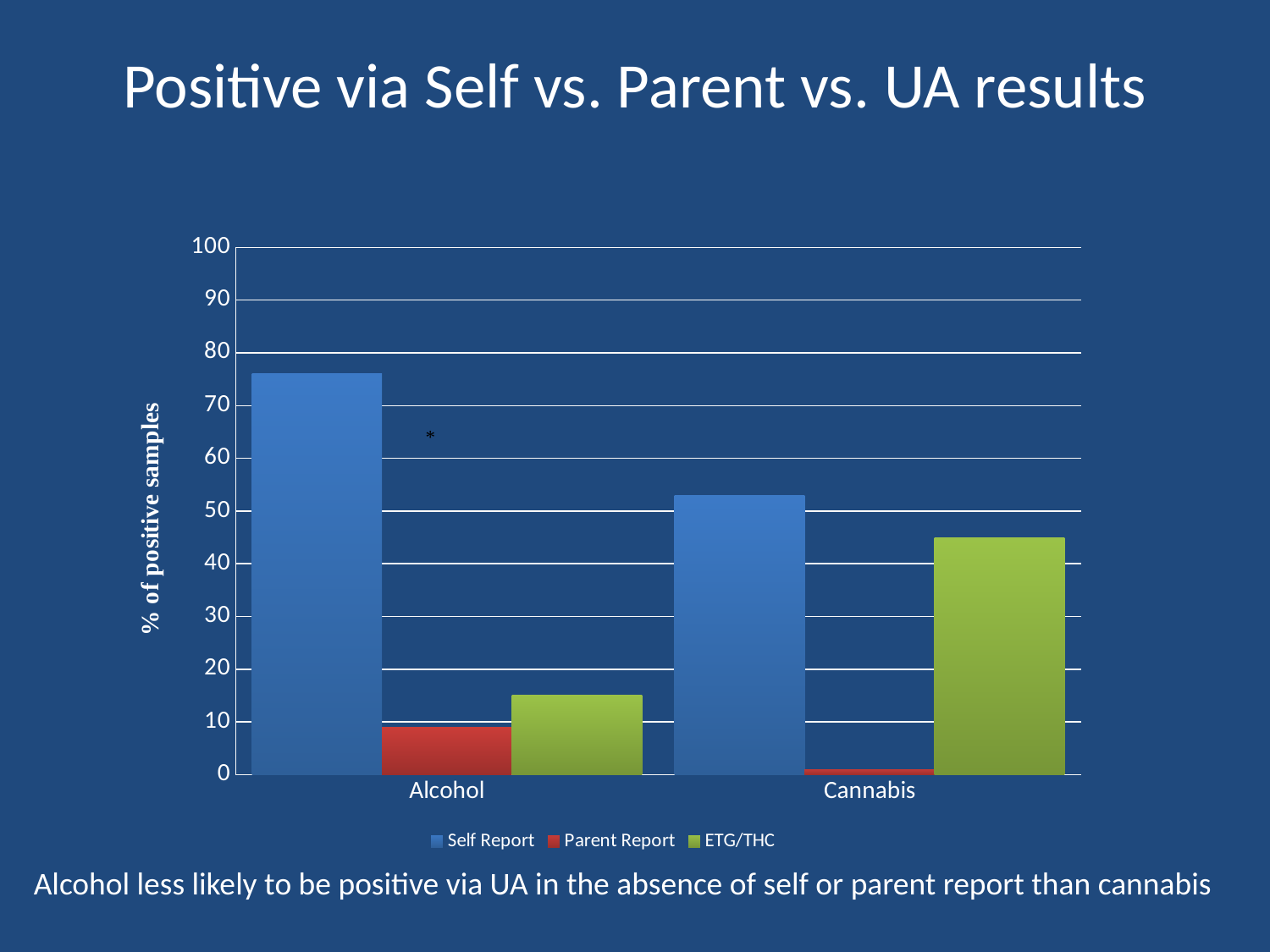
What kind of chart is shown on the slide? bar chart Which series has the lowest value for Cannabis? Parent Report Is the Self Report value for Alcohol greater or less than 70? greater Which is larger: the Self Report value for Alcohol or the Self Report value for Cannabis? Alcohol How many categories are shown on the x axis? 2 What is the label on the y axis? % of positive samples Is the ETG/THC value for Alcohol greater or less than 20? less Is the ETG/THC value for Cannabis greater or less than 40? greater Which is larger: the ETG/THC value for Alcohol or the ETG/THC value for Cannabis? Cannabis Which series has the highest value for Alcohol? Self Report How many series does the legend list? 3